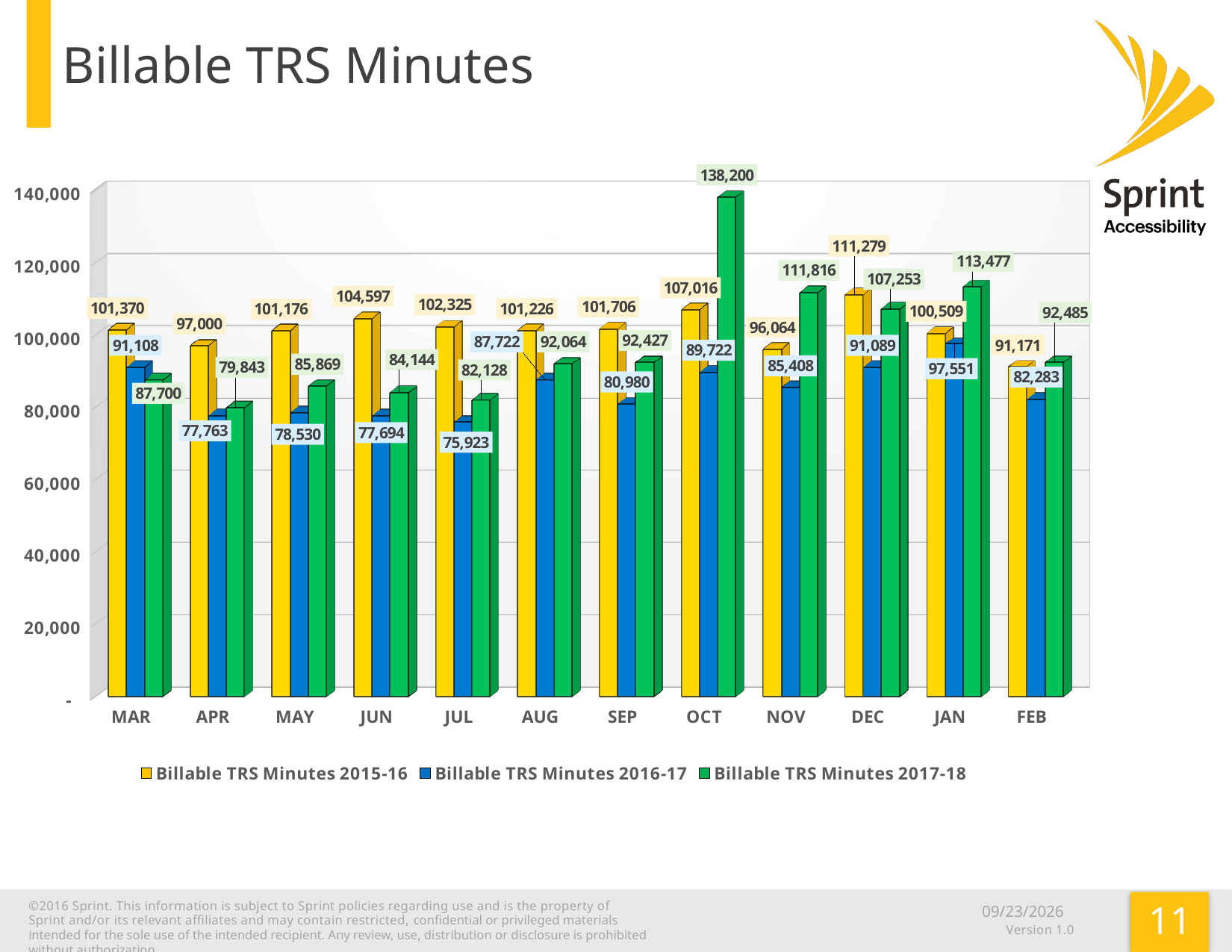
Is the value for Billable TRS Minutes 2017-18 in NOV greater or less than 100,000? greater How many months are shown on the x axis? 12 In DEC, which is larger: Billable TRS Minutes 2015-16 or Billable TRS Minutes 2017-18? Billable TRS Minutes 2015-16 What is the value for Billable TRS Minutes 2017-18 in OCT? 138,200 What is the value for Billable TRS Minutes 2016-17 in JUL? 75,923 Which month has the lowest value for Billable TRS Minutes 2016-17? JUL What is the difference between Billable TRS Minutes 2017-18 and Billable TRS Minutes 2016-17 in OCT? 48,478 How many series does the legend list? 3 What kind of chart is shown on the slide? bar chart Which month has the highest value for Billable TRS Minutes 2017-18? OCT What is the value for Billable TRS Minutes 2015-16 in JUN? 104,597 Which month has the highest value for Billable TRS Minutes 2015-16? DEC